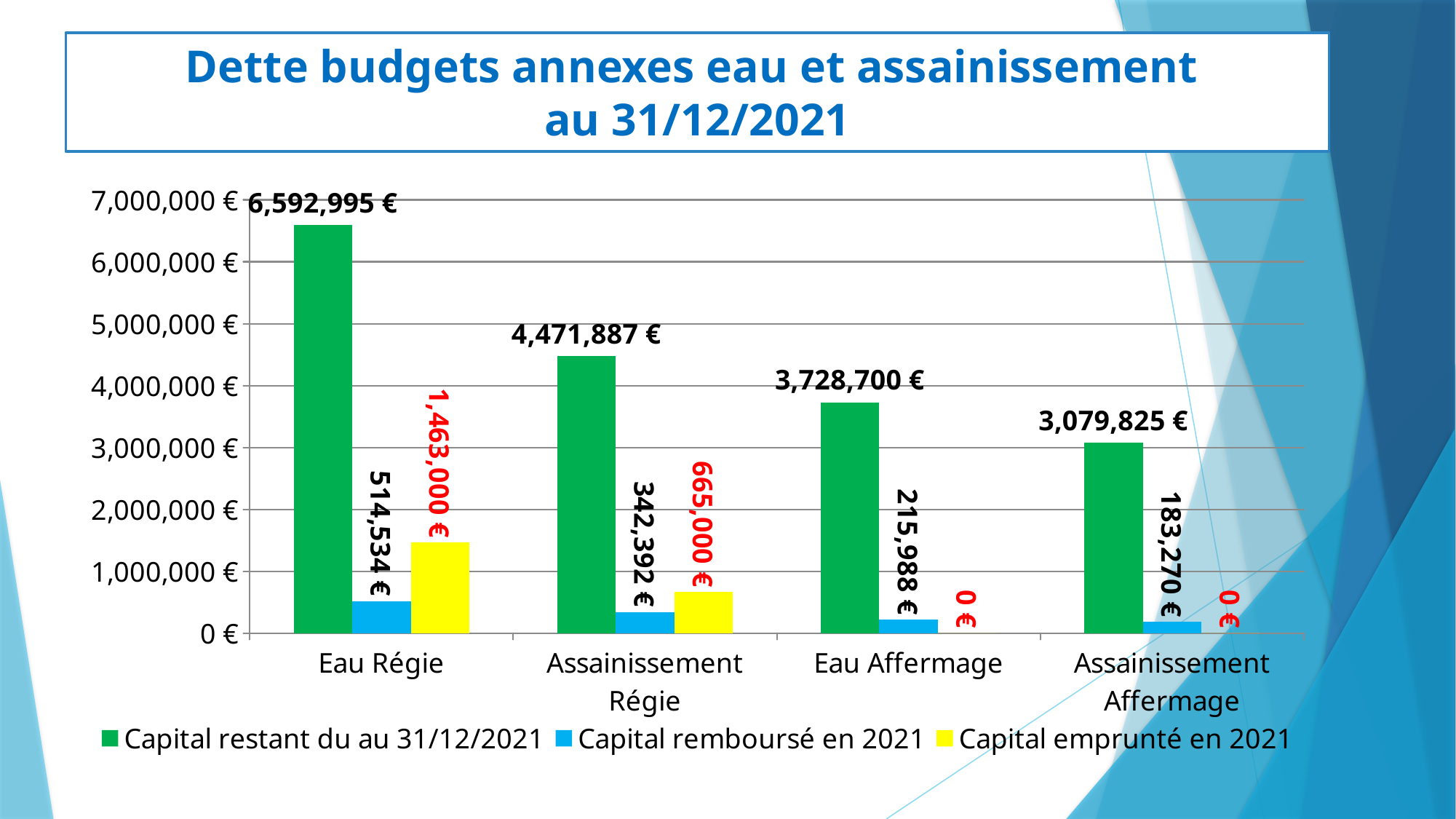
How many categories are shown on the x axis? 4 Which is larger: Capital emprunté en 2021 for Eau Régie or for Assainissement Régie? Eau Régie What is the difference between the Capital restant du au 31/12/2021 for Eau Régie and for Assainissement Régie? 2,121,108 € What is the value of Capital restant du au 31/12/2021 for Assainissement Affermage? 3,079,825 € Which category has the lowest Capital remboursé en 2021? Assainissement Affermage What is the value of Capital restant du au 31/12/2021 for Eau Régie? 6,592,995 € What is the value of Capital emprunté en 2021 for Eau Affermage? 0 € Which category has the highest Capital restant du au 31/12/2021? Eau Régie What is the value of Capital remboursé en 2021 for Assainissement Régie? 342,392 € What type of chart is shown on the slide? Bar chart Does the Capital restant du au 31/12/2021 rise or fall from Eau Régie to Assainissement Affermage along the x axis? Fall How many series does the legend list? 3